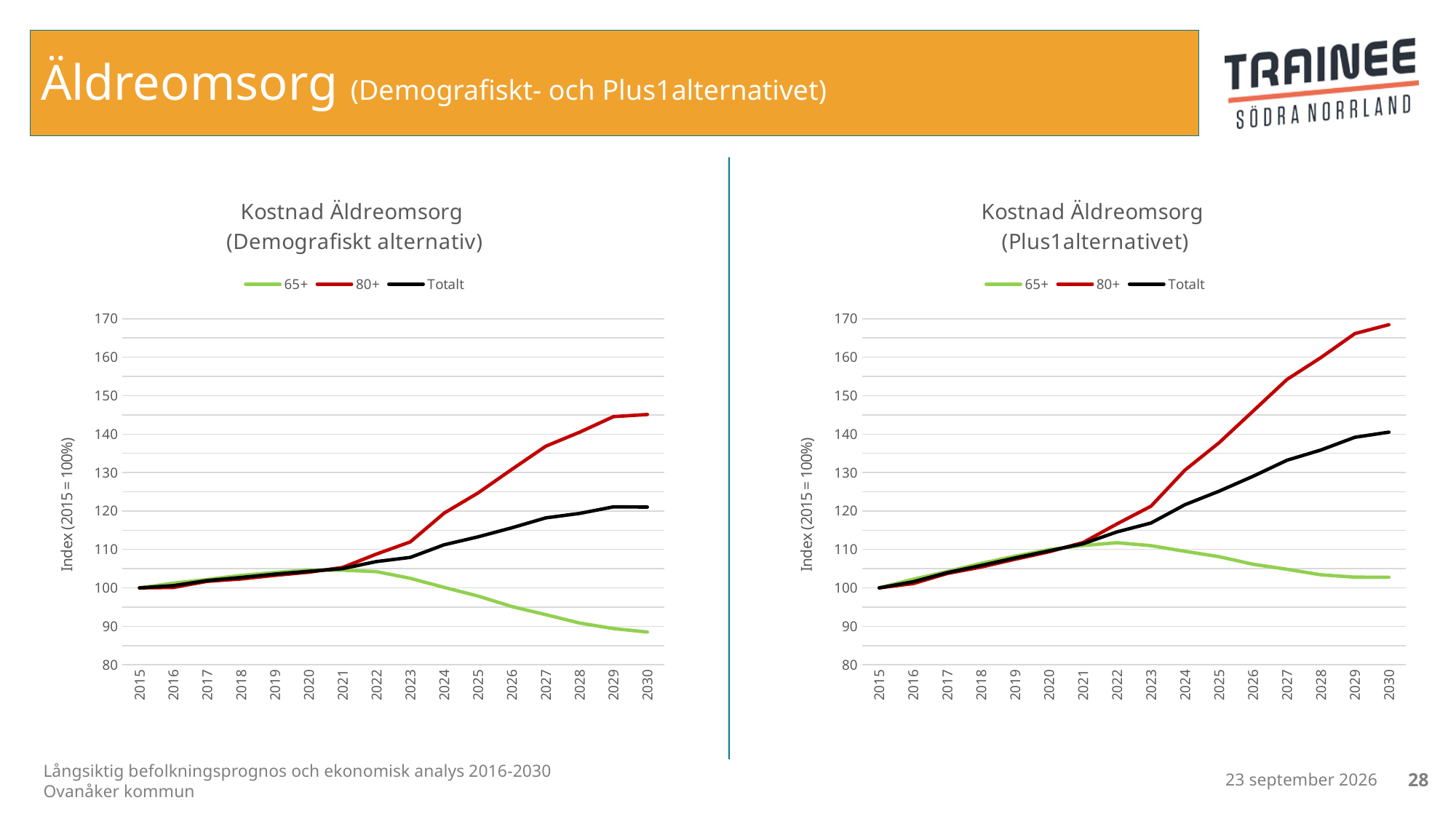
In the right chart, "Kostnad Äldreomsorg (Plus1alternativet)", is the value for Totalt in 2030 greater or less than 130? greater In the left chart, "Kostnad Äldreomsorg (Demografiskt alternativ)", is the value for 65+ in 2030 greater or less than 90? less In the left chart, "Kostnad Äldreomsorg (Demografiskt alternativ)", which series has the lowest value in 2030? 65+ In the left chart, "Kostnad Äldreomsorg (Demografiskt alternativ)", what is the index value for Totalt in 2015? 100 In the left chart, "Kostnad Äldreomsorg (Demografiskt alternativ)", is the value for 80+ in 2030 greater or less than 140? greater In the left chart, "Kostnad Äldreomsorg (Demografiskt alternativ)", which series has the highest value in 2030? 80+ What type of chart is the left chart, "Kostnad Äldreomsorg (Demografiskt alternativ)"? Line chart How many years are shown on the x axis of the left chart, "Kostnad Äldreomsorg (Demografiskt alternativ)"? 16 Is the 2030 value for 80+ larger in the right chart (Plus1alternativet) or in the left chart (Demografiskt alternativ)? Right chart (Plus1alternativet) How many series does the legend of the right chart, "Kostnad Äldreomsorg (Plus1alternativet)", list? 3 In the left chart, "Kostnad Äldreomsorg (Demografiskt alternativ)", does the 65+ series rise or fall between 2021 and 2030? Fall